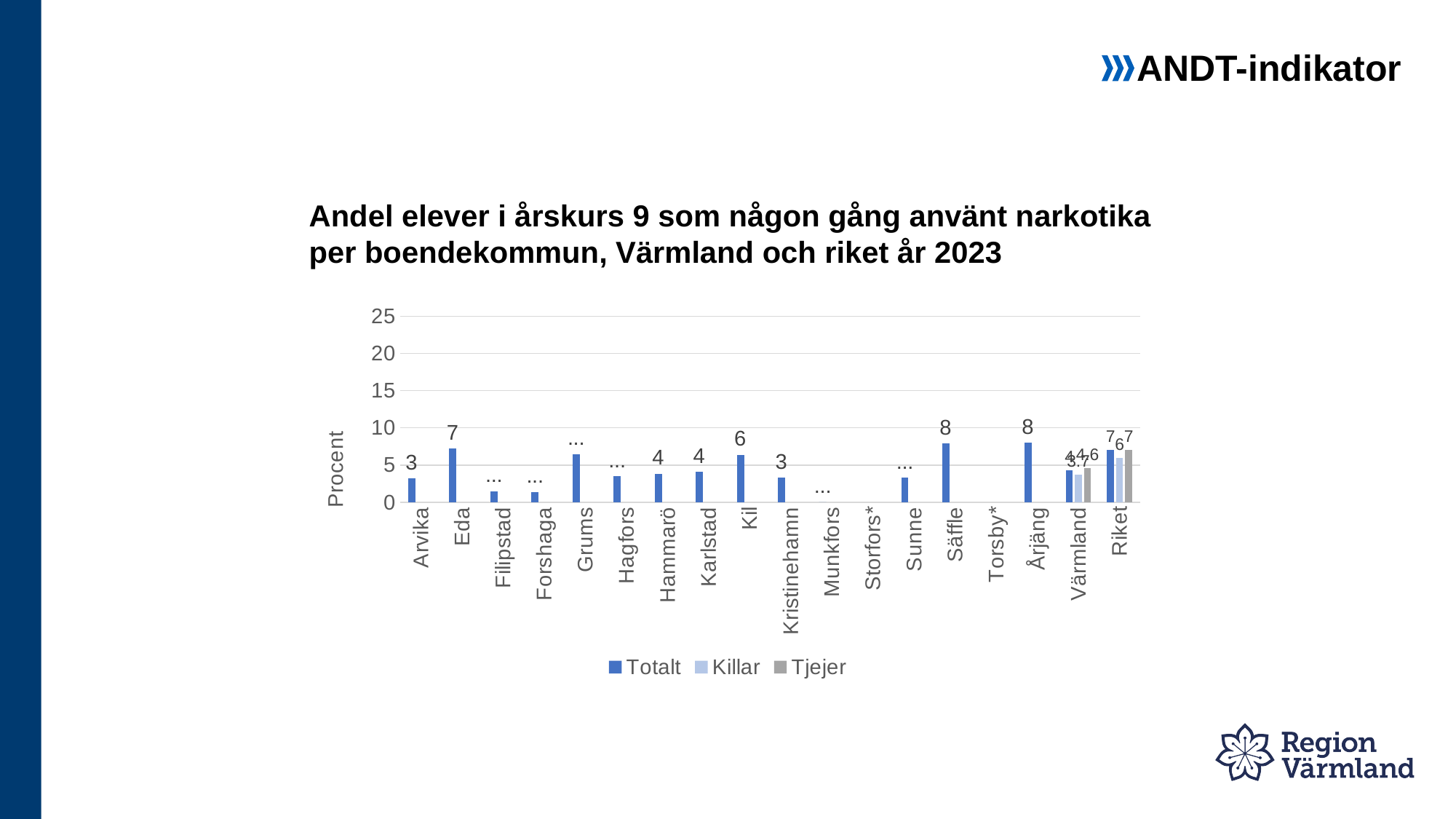
Which has the larger Totalt value, Kil or Hammarö? Kil What is the difference between the Totalt values for Eda and Arvika? 4 What kind of chart is shown on the slide? bar chart What is the Totalt value for Eda? 7 What is the Killar value for Värmland? 3.7 What is the Totalt value for Säffle? 8 What is the Totalt value for Kil? 6 How many series does the legend list? 3 How many categories are shown on the x axis? 18 What is the Tjejer value for Värmland? 4.6 What is the Killar value for Riket? 6 Is the Totalt value for Säffle greater or less than 10? less